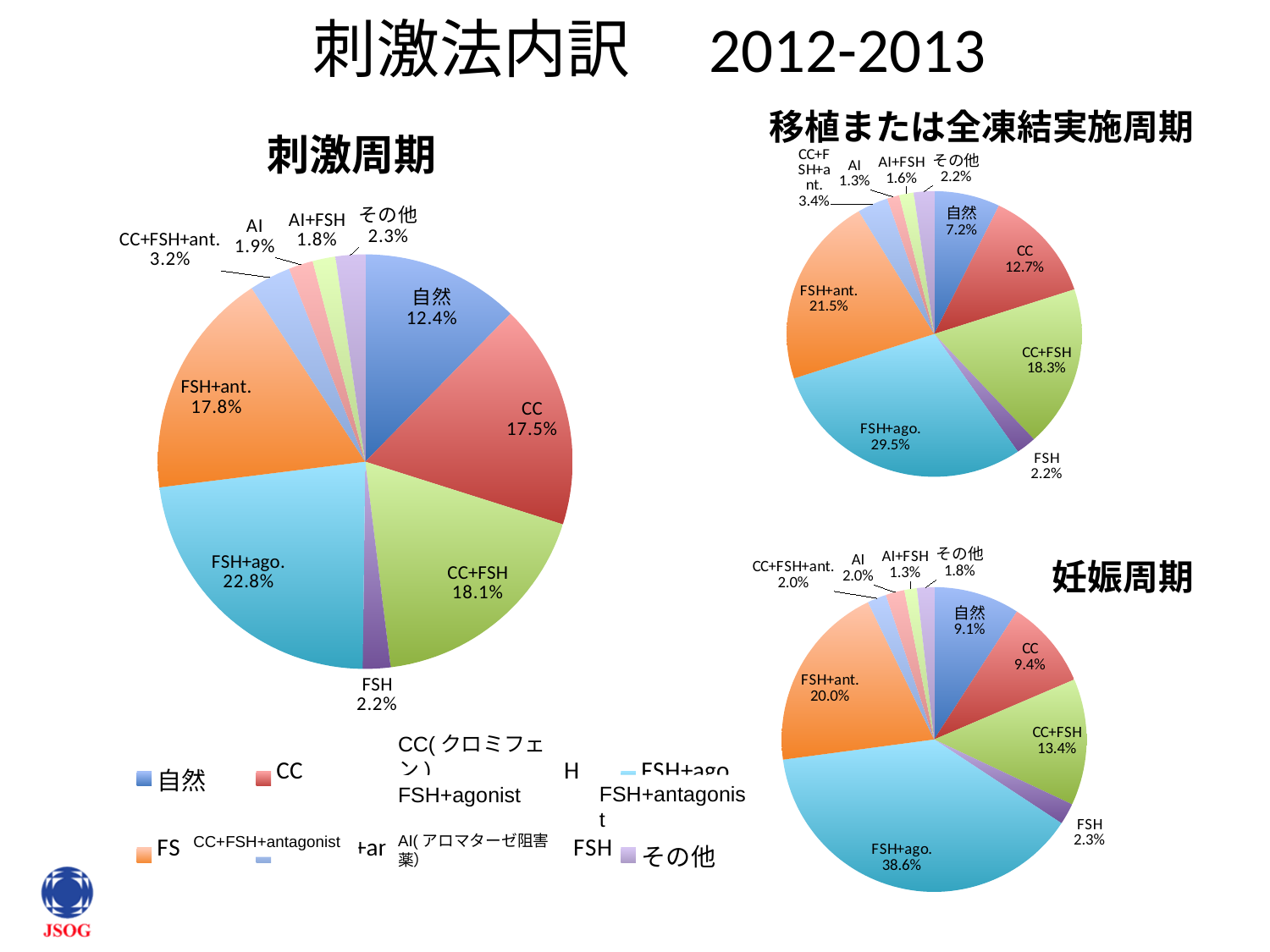
In the 刺激周期 chart, how many slices does the pie have? 10 In the 移植または全凍結実施周期 chart, which category has the smallest share? AI In the 移植または全凍結実施周期 chart, what is the share for FSH+ant.? 21.5% In the 刺激周期 chart, which category has the largest share? FSH+ago. In the 移植または全凍結実施周期 chart, which is larger, the share for CC or the share for CC+FSH? CC+FSH What kind of chart is the 刺激周期 chart? pie chart In the 妊娠周期 chart, what is the difference between the FSH+ant. share and the CC+FSH share? 6.6% In the 妊娠周期 chart, what is the share for FSH+ago.? 38.6% In the 刺激周期 chart, what is the share for FSH+ago.? 22.8% How many pie charts are shown on the slide? 3 In the 刺激周期 chart, what is the difference between the CC+FSH share and the CC share? 0.6% In the 妊娠周期 chart, which category has the smallest share? AI+FSH